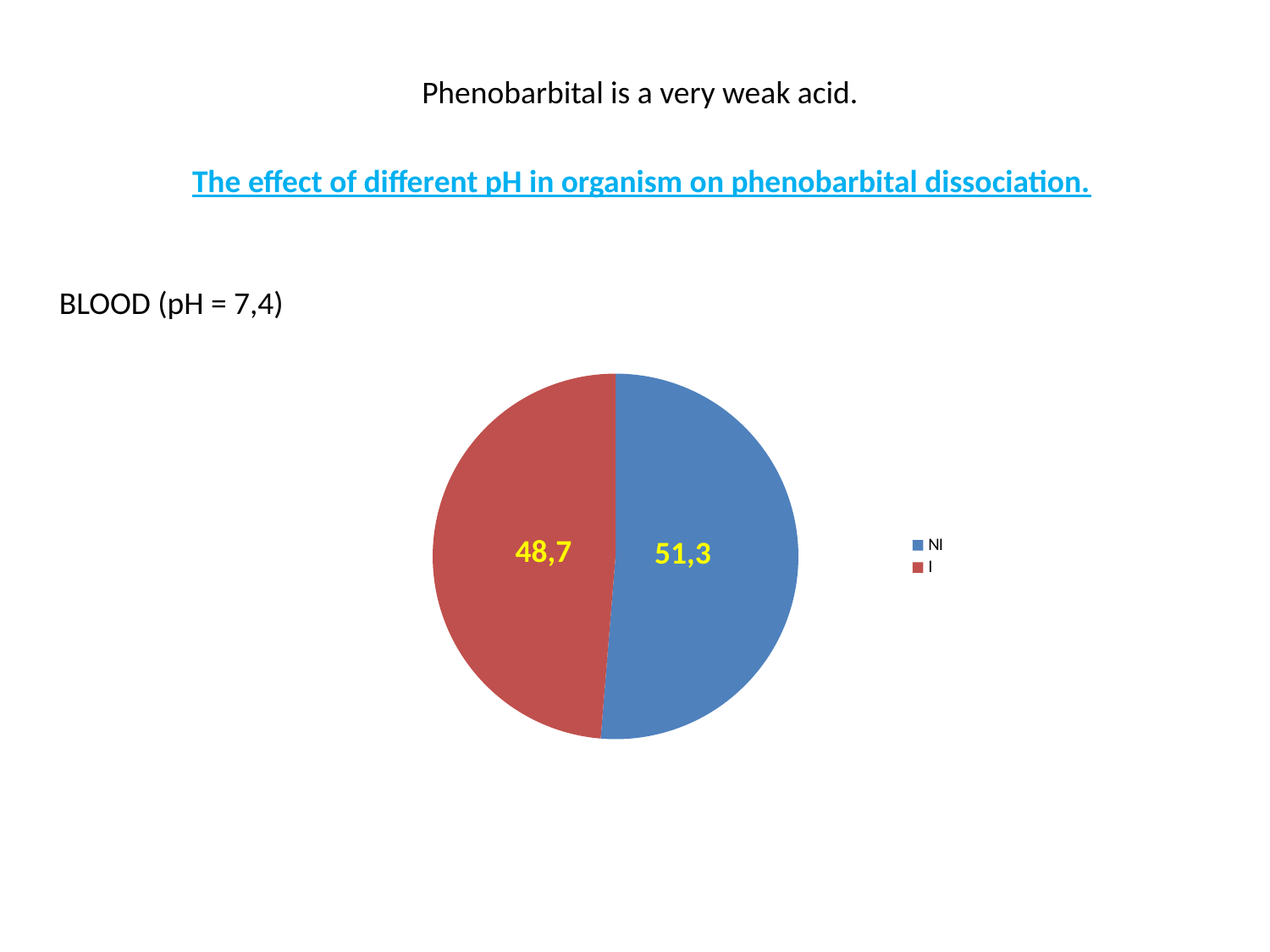
What is the difference between the NI value and the I value in the pie chart? 2,6 What colour is the I slice in the pie chart? Red What kind of chart is shown on the slide? Pie chart Which is larger in the pie chart, NI or I? NI How many slices does the pie chart have? 2 Which slice of the pie chart has the largest value? NI What colour is the NI slice in the pie chart? Blue Which slice of the pie chart has the smallest value? I How many entries does the legend of the pie chart list? 2 What is the value shown for the I slice of the pie chart? 48,7 What is the value shown for the NI slice of the pie chart? 51,3